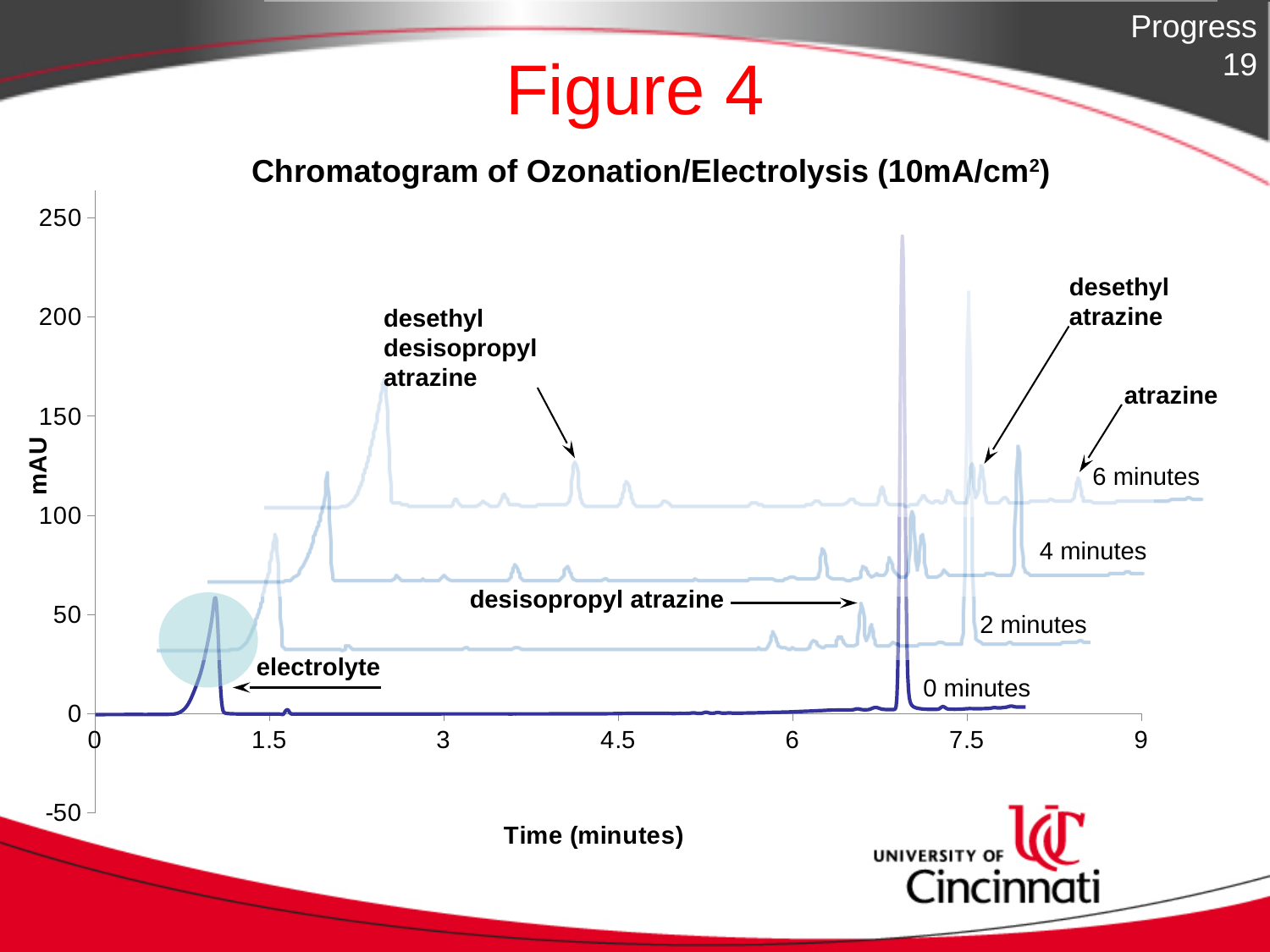
Does the peak labelled atrazine occur at a time greater or less than 7.5 minutes? greater Is the height of the electrolyte peak on the 0 minutes trace greater or less than 100 mAU? less What is the label of the y axis? mAU Which trace is plotted lowest on the chart? 0 minutes Is the tallest peak near 7 minutes greater or less than 200 mAU? greater What kind of chart is shown on the slide? line chart What is the title of the chart? Chromatogram of Ozonation/Electrolysis (10mA/cm²) Which trace is plotted highest on the chart? 6 minutes How many time traces (0, 2, 4, 6 minutes) are plotted on the chart? 4